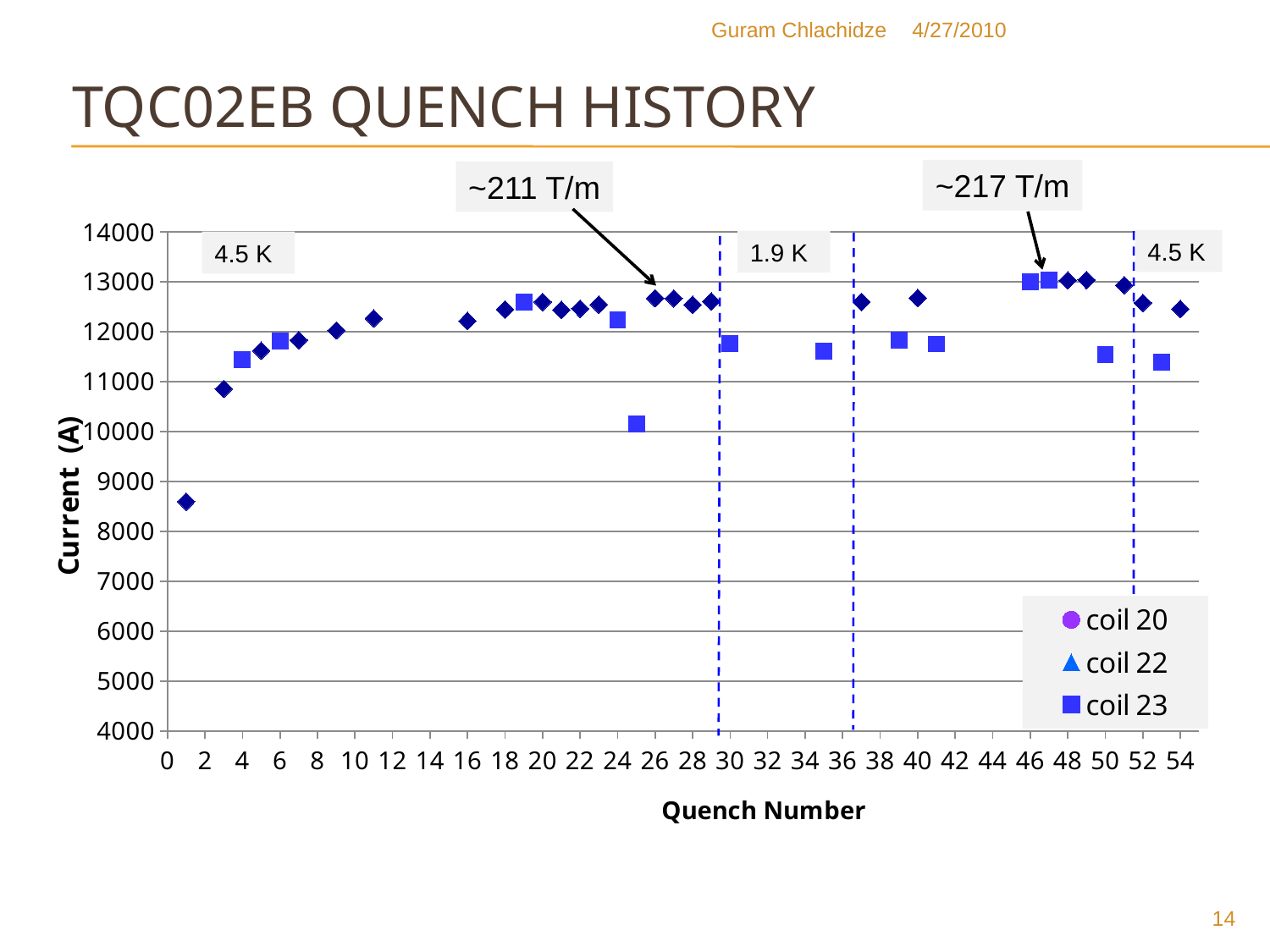
Is the current for quench number 1 greater or less than 8000? greater Which has the higher current, quench number 1 or quench number 3? quench number 3 Is the current for quench number 1 greater or less than 9000? less What kind of chart is shown on the slide? scatter chart What is the title of the x axis? Quench Number Is the current for quench number 11 greater or less than 12000? greater How many series does the legend list? 3 Do the current values rise or fall from quench number 1 to quench number 11? rise Which quench number has the lowest current? 1